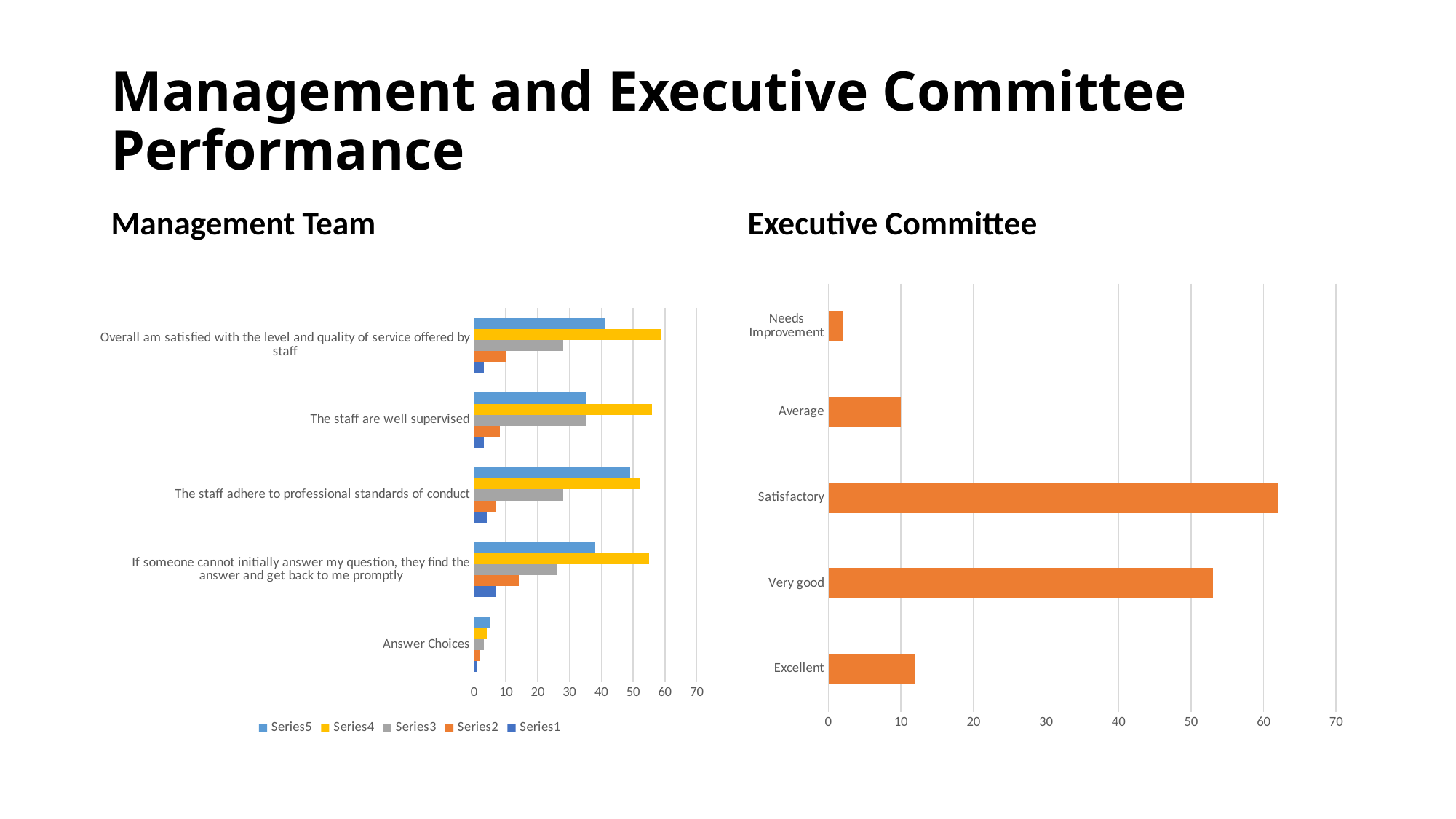
How many categories does the Executive Committee chart show? 5 In the Executive Committee chart, is the value for Very good greater or less than 50? greater How many series does the legend of the Management Team chart list? 5 In the Executive Committee chart, which category has the lowest value? Needs Improvement In the Executive Committee chart, which is larger, the value for Satisfactory or the value for Very good? Satisfactory In the Executive Committee chart, is the value for Satisfactory greater or less than 60? greater In the Management Team chart, what colour are the Series4 bars? yellow In the Executive Committee chart, which category has the highest value? Satisfactory What kind of chart is the Executive Committee chart? bar chart In the Executive Committee chart, is the value for Needs Improvement greater or less than 10? less